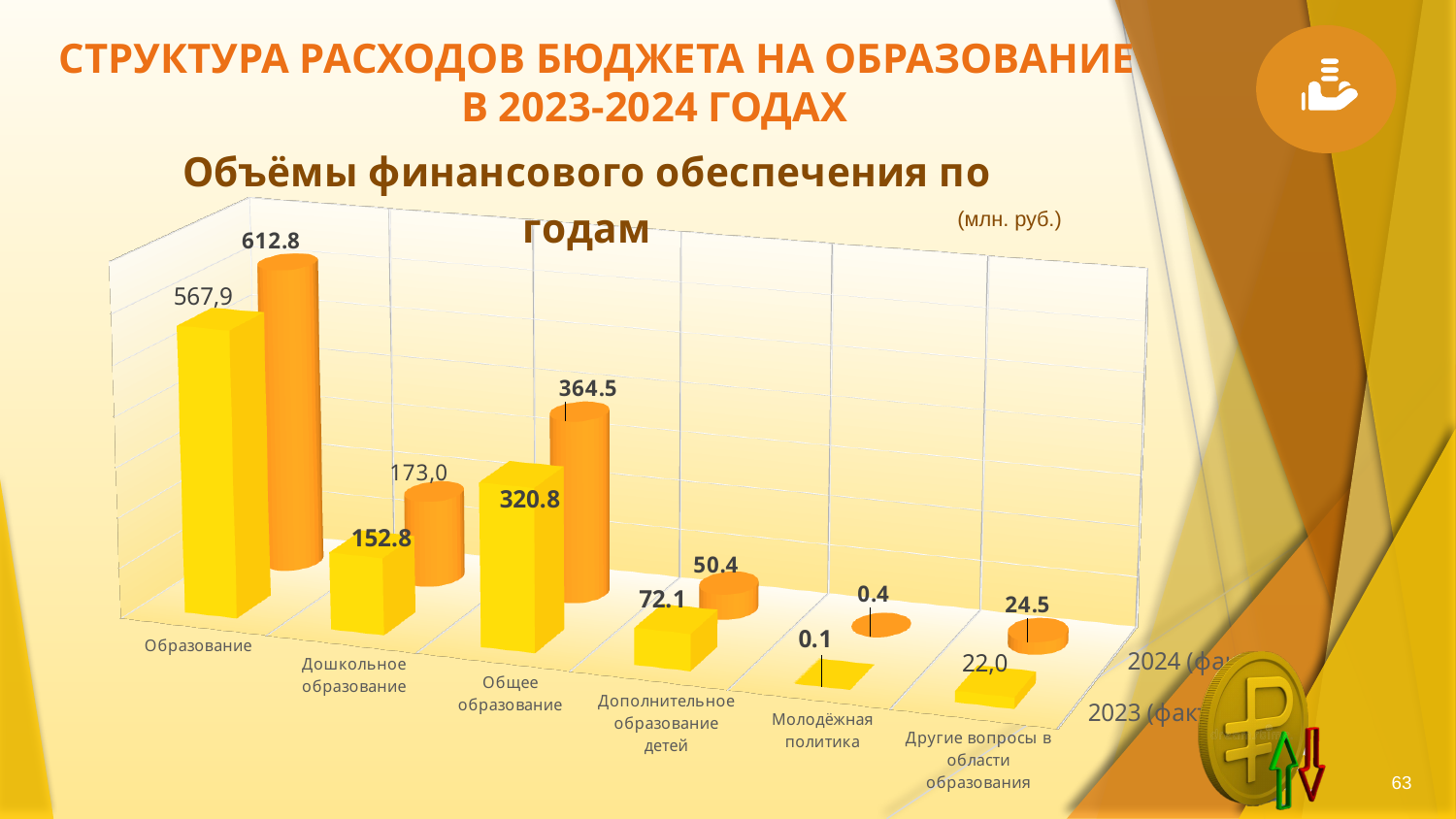
What is the 2023 value for Общее образование? 320.8 Which category has the lowest 2023 value? Молодёжная политика What is the 2024 value for Дошкольное образование? 173,0 Which is larger for Дополнительное образование детей: the 2023 value or the 2024 value? 2023 What is the 2024 value for Другие вопросы в области образования? 24.5 What is the 2023 value for Молодёжная политика? 0.1 How many series does the chart show? 2 What kind of chart is shown on the slide? Bar chart Which category has the highest 2024 value? Образование What is the 2024 value for Образование? 612.8 What is the difference between the 2024 and 2023 values for Общее образование? 43.7 How many categories are shown on the x axis? 6